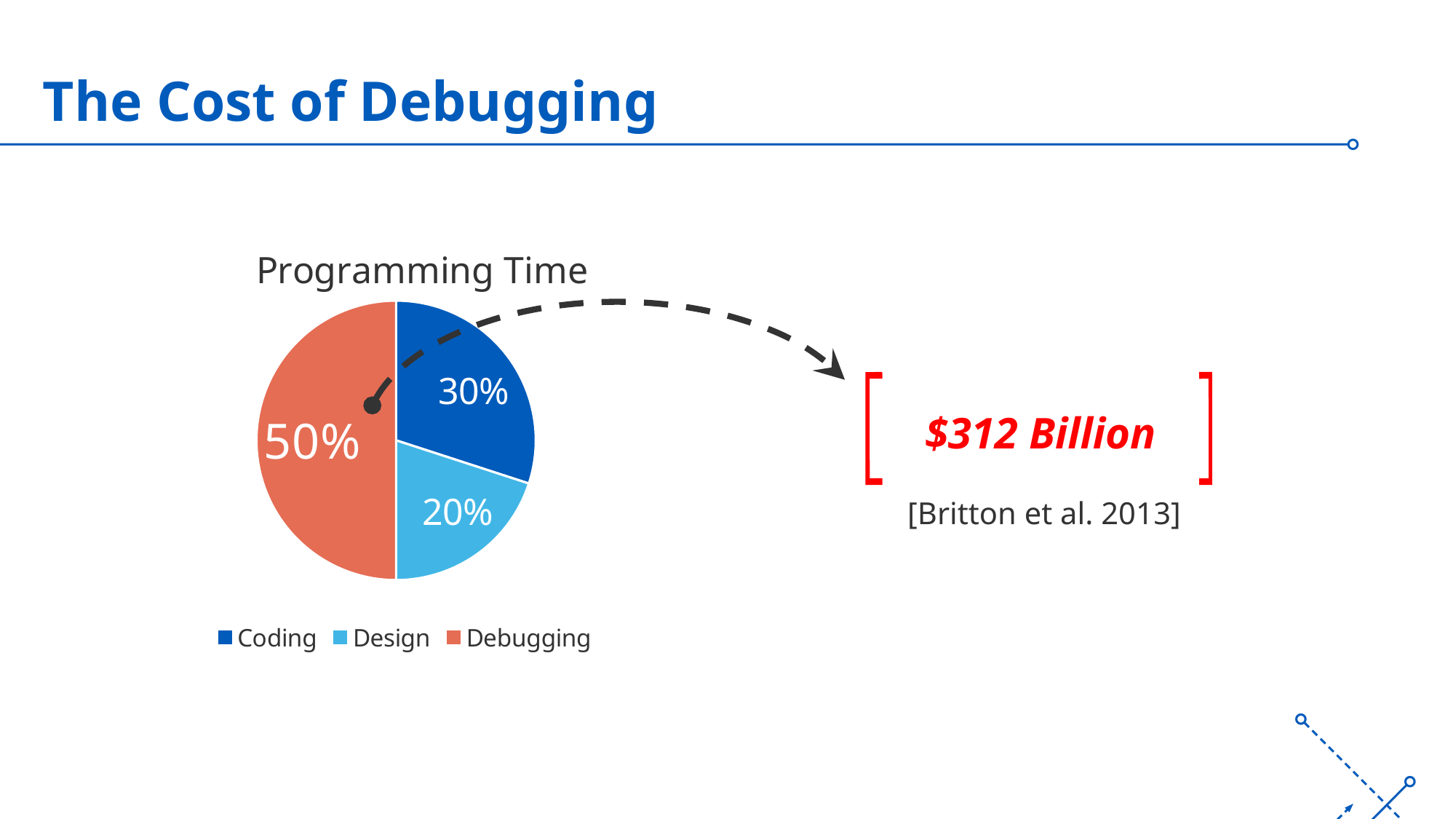
What colour represents Debugging in the pie chart? orange-red Which category takes the smallest share of programming time? Design What percentage of programming time is spent on Coding? 30% What is the title of the chart? Programming Time Which category takes the largest share of programming time? Debugging What is the difference in percentage points between Debugging and Coding? 20 What is the combined share of Coding and Design? 50% How many categories does the pie chart show? 3 Which is larger, the share for Coding or the share for Design? Coding What percentage of programming time is spent on Debugging? 50% What percentage of programming time is spent on Design? 20% What type of chart is shown on the slide? pie chart